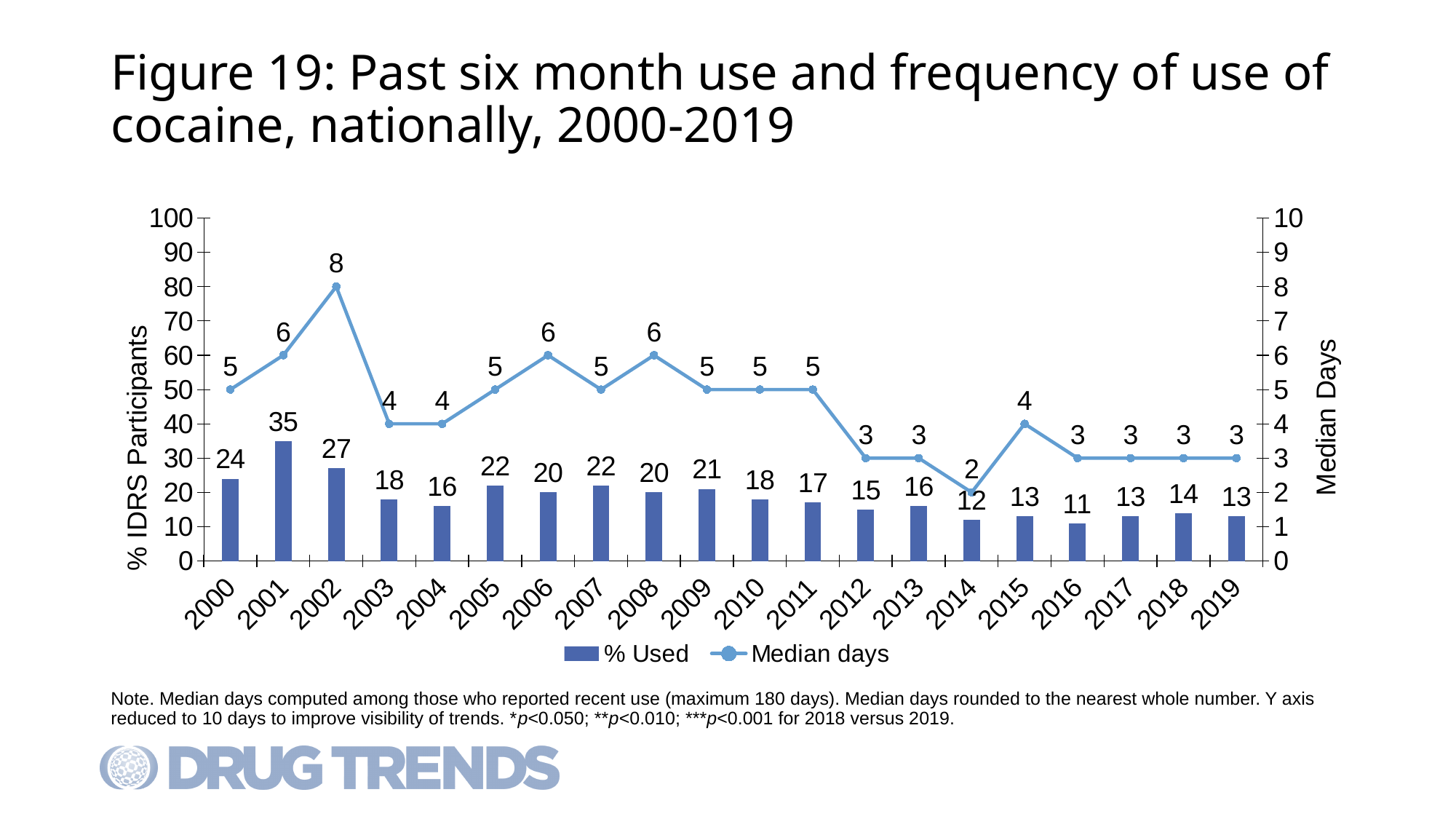
What is the % Used value for 2001? 35 What is the label of the right-hand y axis? Median Days How many series does the legend list? 2 What kind of chart is used for the % Used series? Bar chart What is the Median days value for 2002? 8 What is the % Used value for 2019? 13 How many years are shown on the x axis? 20 What is the difference in % Used between 2001 and 2002? 8 Which is larger, the % Used value for 2005 or for 2010? 2005 Which year has the highest % Used value? 2001 Which year has the lowest Median days value? 2014 Which year has the lowest % Used value? 2016